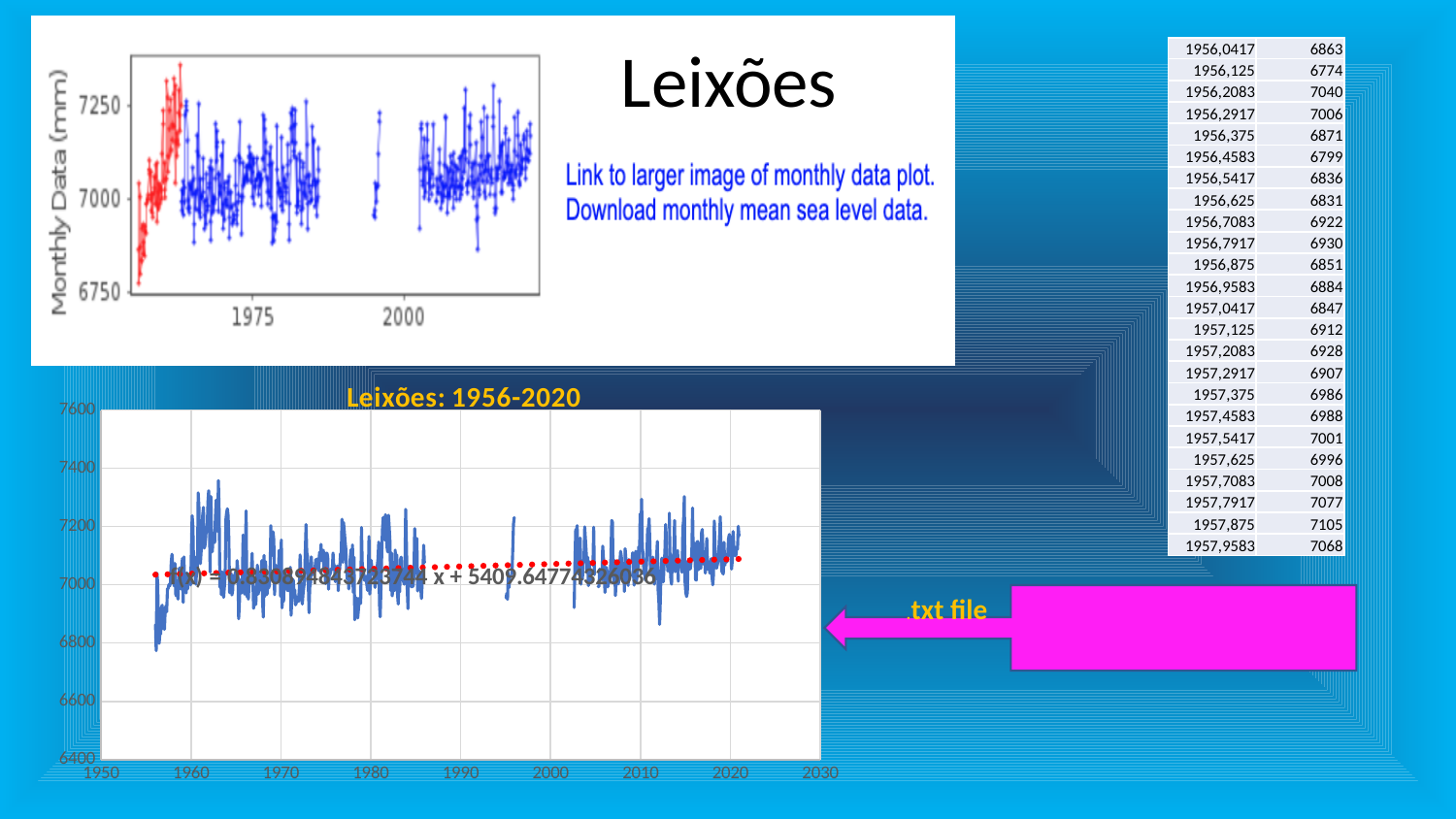
In the top-left chart, is the lowest red data point greater or less than 7000? less What kind of chart is the bottom chart titled 'Leixões: 1956-2020'? line chart What is the y-axis label of the top-left chart? Monthly Data (mm) In the bottom chart 'Leixões: 1956-2020', what is the highest value shown on the y axis? 7600 What is the title of the bottom chart? Leixões: 1956-2020 In the bottom chart 'Leixões: 1956-2020', does the dotted trendline rise or fall from left to right? rise In the top-left chart, is the value around 1975 greater or less than 7250? less In the bottom chart 'Leixões: 1956-2020', is the value at the very start of the series (around 1956) greater or less than 7000? less In the top-left chart, do the red data points at the start of the series rise or fall over time? rise What kind of chart is the top-left chart with the 'Monthly Data (mm)' axis? line chart